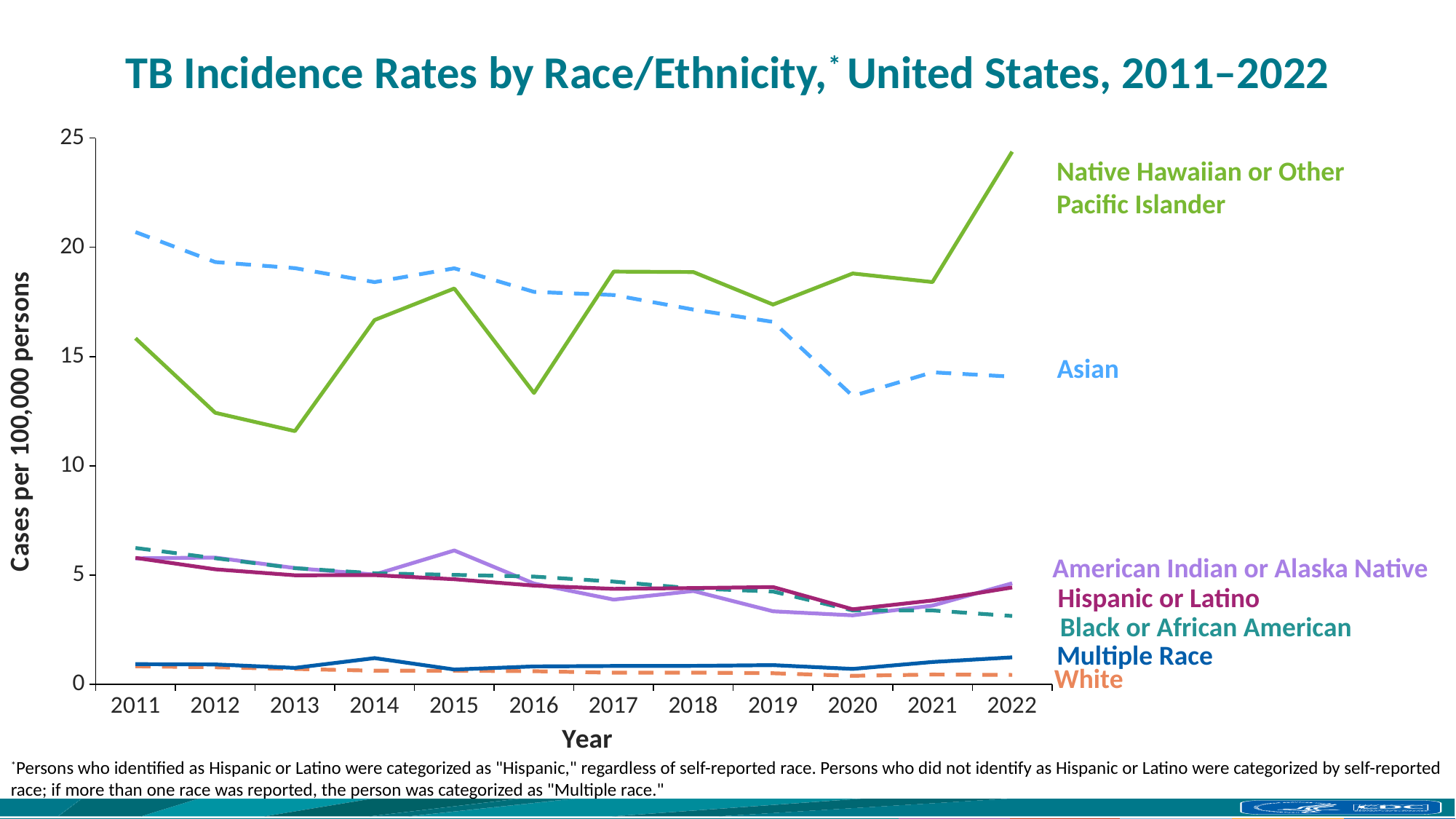
Which group has the highest TB incidence rate in 2011? Asian Is the value for Native Hawaiian or Other Pacific Islander in 2022 greater or less than 20? greater Is the value for White in 2022 greater or less than 5? less What is the label on the y axis? Cases per 100,000 persons Which group has the highest TB incidence rate in 2022? Native Hawaiian or Other Pacific Islander What kind of chart is shown on the slide? Line chart How many years are shown along the x axis? 12 In 2016, which is larger: the rate for Asian or the rate for Native Hawaiian or Other Pacific Islander? Asian Is the value for Asian in 2020 greater or less than 15? less Does the Asian line overall rise or fall from 2011 to 2022? Fall Which group has the lowest TB incidence rate in 2022? White How many race/ethnicity groups (series) are plotted on the chart? 7